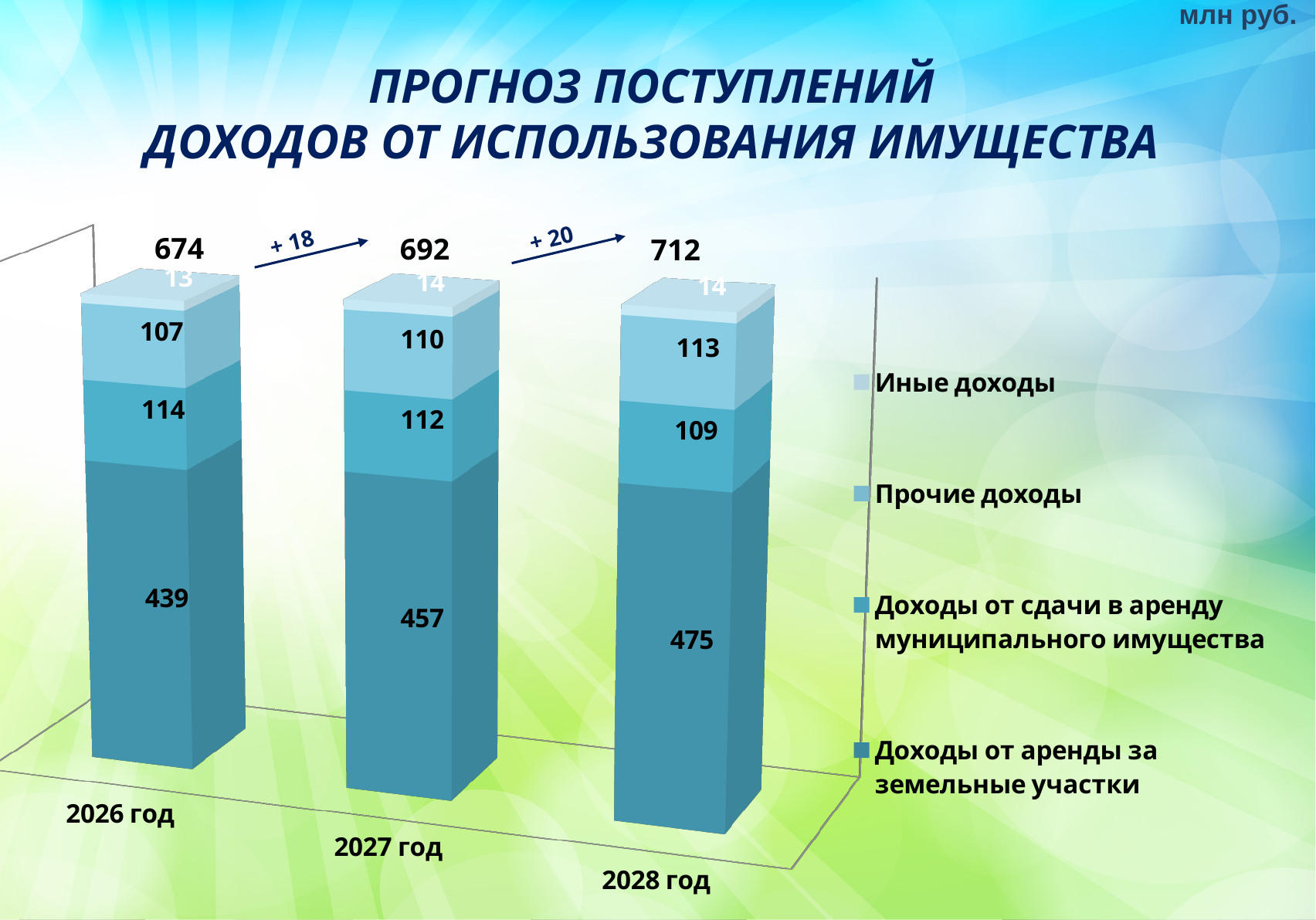
What is the difference between the totals for 2027 год and 2026 год? 18 What is the value of Иные доходы for 2027 год? 14 Which year has the highest total? 2028 год How many series does the legend list? 4 What is the total value of the stacked bar for 2026 год? 674 What kind of chart is shown on the slide? Stacked bar chart Which year has the lowest value for Доходы от аренды за земельные участки? 2026 год What is the value of Прочие доходы for 2028 год? 113 What is the total value of the stacked bar for 2028 год? 712 Which is larger: Доходы от сдачи в аренду муниципального имущества in 2026 год or in 2028 год? 2026 год What is the value of Доходы от аренды за земельные участки for 2027 год? 457 What is the value of Доходы от сдачи в аренду муниципального имущества for 2026 год? 114